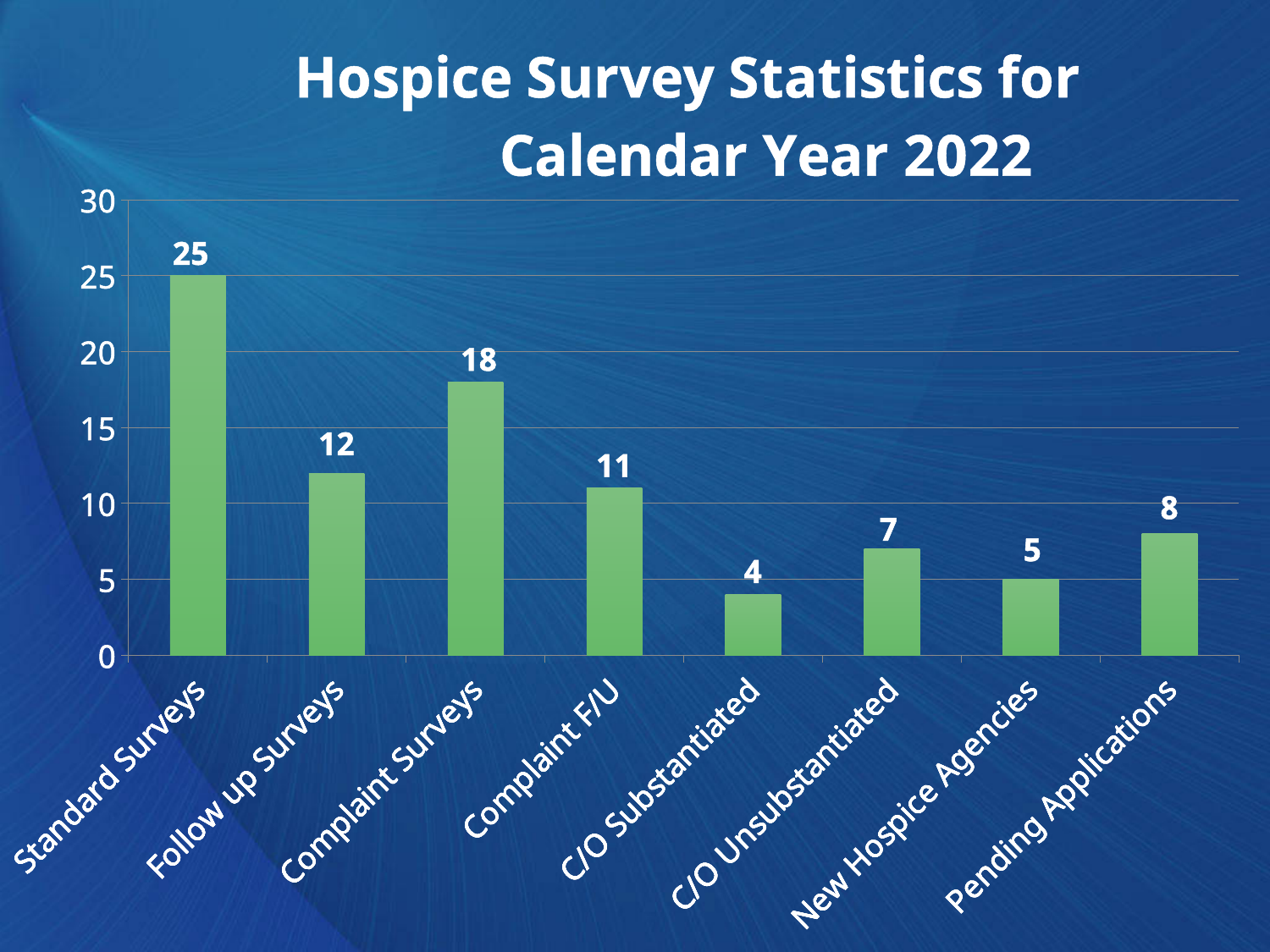
What is the value for Complaint F/U? 11 What kind of chart is shown on the slide? bar chart Is the value for Complaint Surveys greater or less than 15? greater Which is larger, C/O Unsubstantiated or C/O Substantiated? C/O Unsubstantiated What is the title of the chart? Hospice Survey Statistics for Calendar Year 2022 What is the difference between Standard Surveys and Complaint Surveys? 7 Which category has the highest value? Standard Surveys Which category has the lowest value? C/O Substantiated What is the difference between Follow up Surveys and Pending Applications? 4 How many categories are shown on the chart? 8 What is the value for New Hospice Agencies? 5 What is the value for Standard Surveys? 25